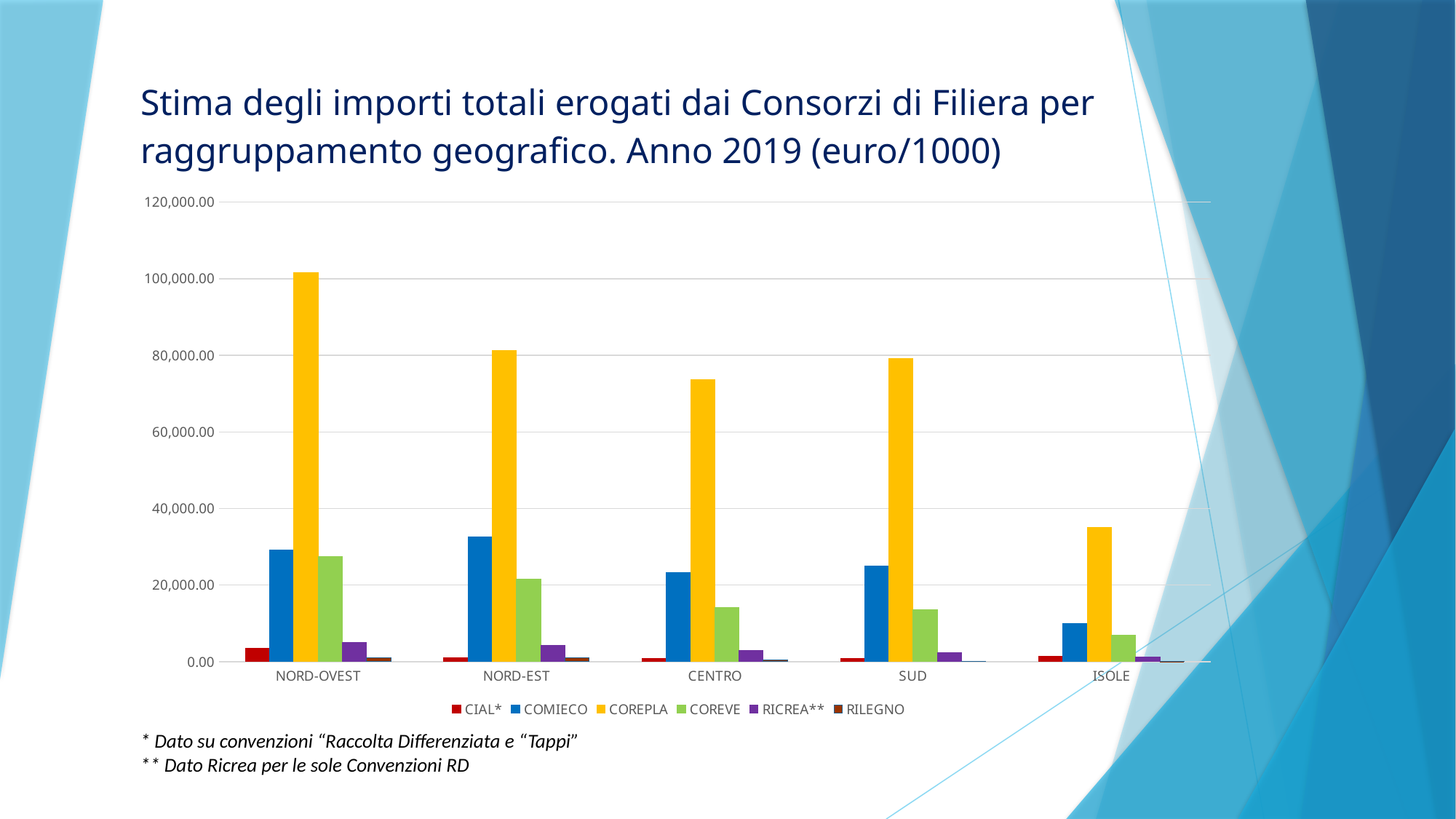
Is the COREPLA value for NORD-OVEST greater or less than 80,000.00? greater Which series has the highest value in SUD? COREPLA How many series does the legend list? 6 Which is larger, the COMIECO value for NORD-EST or for NORD-OVEST? NORD-EST Which is larger, the COREPLA value for NORD-EST or for CENTRO? NORD-EST Which geographic grouping has the highest COREPLA value? NORD-OVEST Do the COREVE values rise or fall moving from NORD-OVEST to ISOLE along the x axis? fall What kind of chart is shown on the slide? bar chart Is the COREPLA value for ISOLE greater or less than 40,000.00? less Is the COMIECO value for CENTRO greater or less than 20,000.00? greater How many geographic groupings are shown on the x axis? 5 Which geographic grouping has the lowest COREPLA value? ISOLE